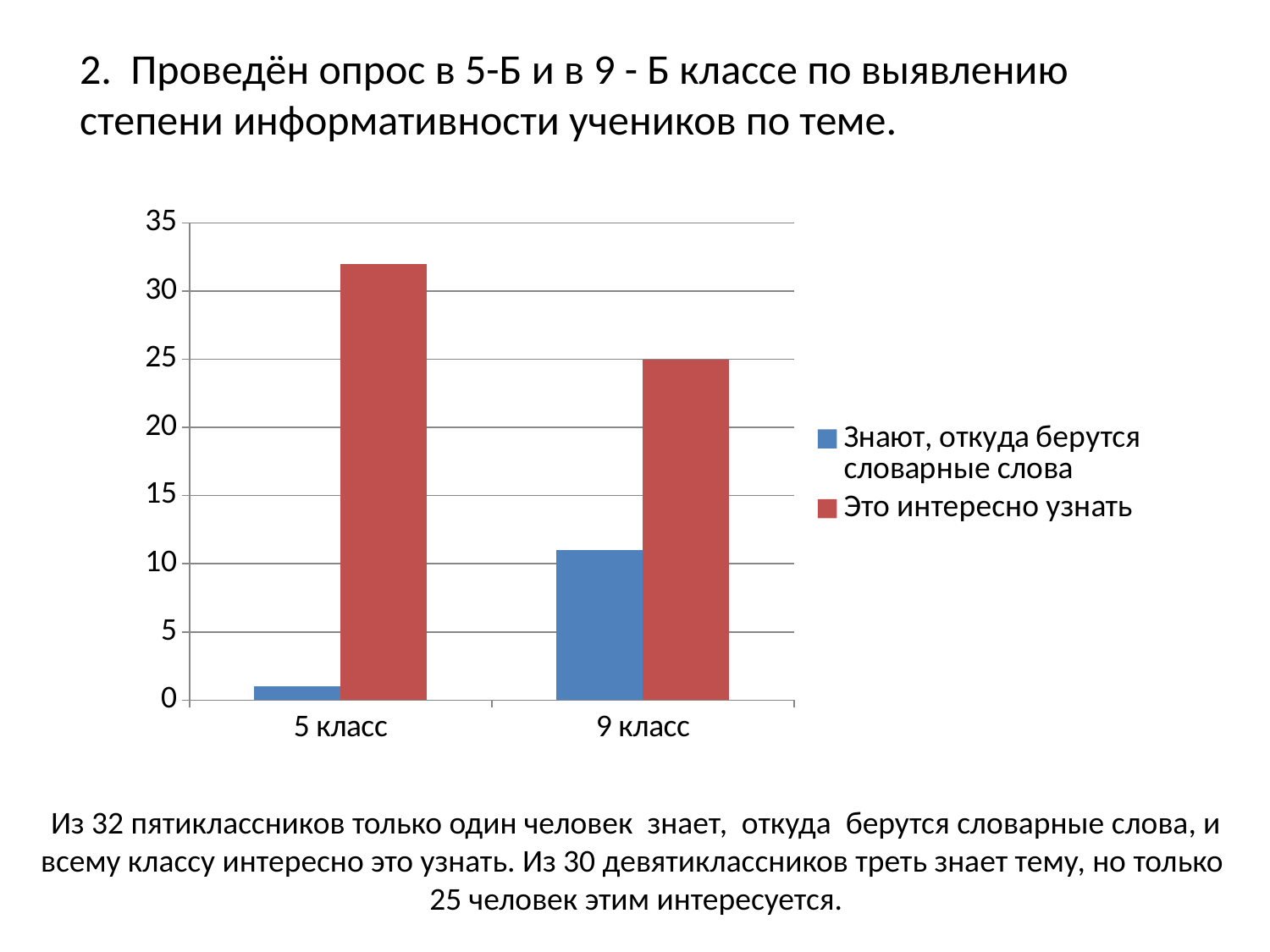
Does the value for "Это интересно узнать" rise or fall from "5 класс" to "9 класс"? fall How many categories are shown on the x axis of the chart? 2 Is the value for "Знают, откуда берутся словарные слова" in the "9 класс" category greater or less than 15? less Which category has the highest value for "Это интересно узнать"? 5 класс Is the value for "Знают, откуда берутся словарные слова" in the "5 класс" category greater or less than 5? less For the series "Знают, откуда берутся словарные слова", which category has the larger value, "5 класс" or "9 класс"? 9 класс What is the value for "Это интересно узнать" in the "9 класс" category? 25 Is the value for "Это интересно узнать" in the "5 класс" category greater or less than 30? greater How many series does the chart's legend list? 2 What kind of chart is shown on the slide? bar chart What colour are the bars for the series "Это интересно узнать"? red In the "9 класс" category, which series has the larger value? Это интересно узнать